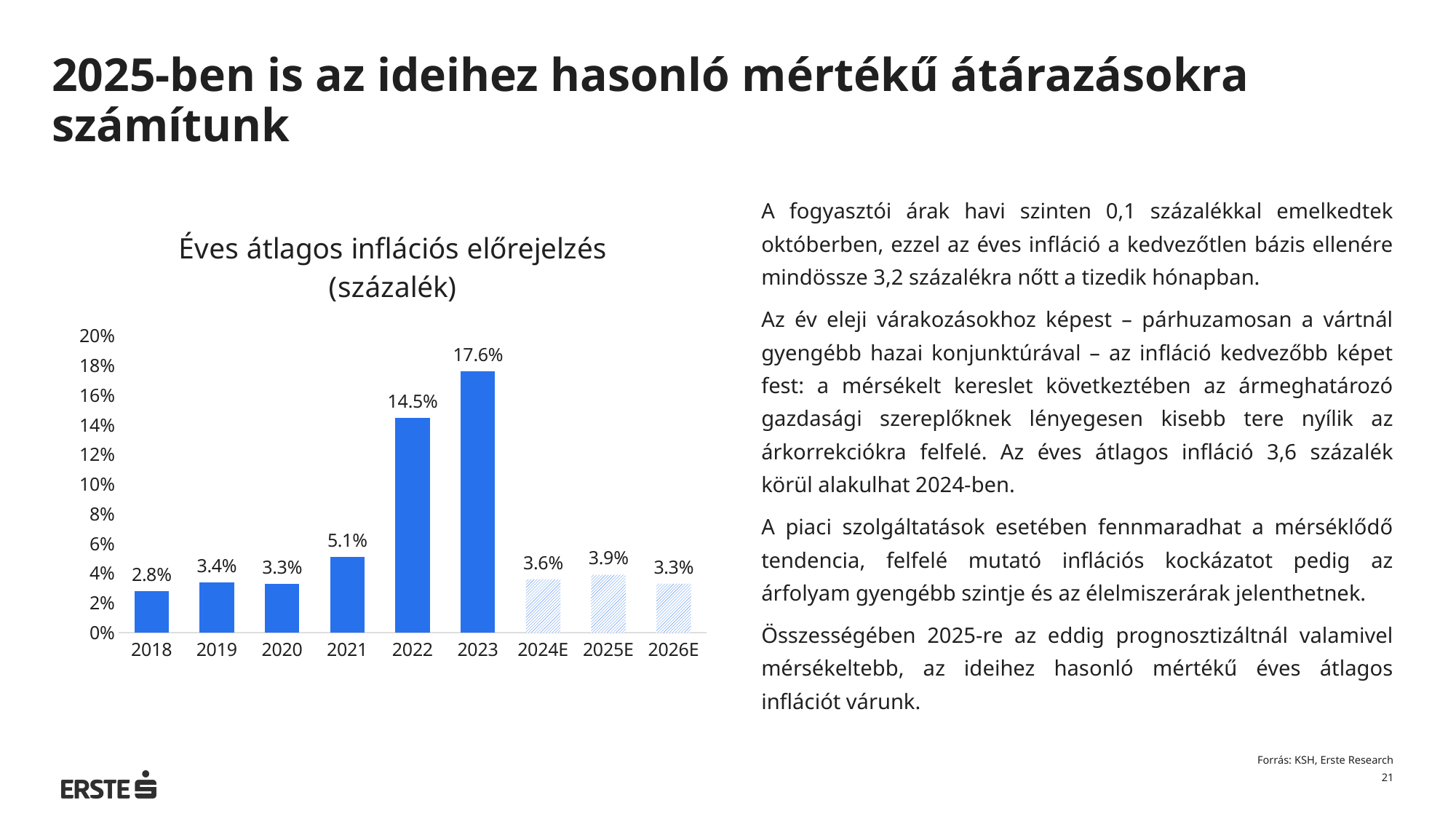
Is the value for 2022 greater or less than 10%? greater What is the difference between the values for 2023 and 2022? 3.1% What is the value for 2018? 2.8% How many years are shown on the x axis? 9 What kind of chart is shown? bar chart What is the title of the chart? Éves átlagos inflációs előrejelzés (százalék) Which year has the lowest value? 2018 Do the values rise or fall from 2023 to 2024E? fall Which year has the highest value? 2023 What is the value for 2023? 17.6% Which is larger, the value for 2025E or the value for 2026E? 2025E What is the value for 2024E? 3.6%